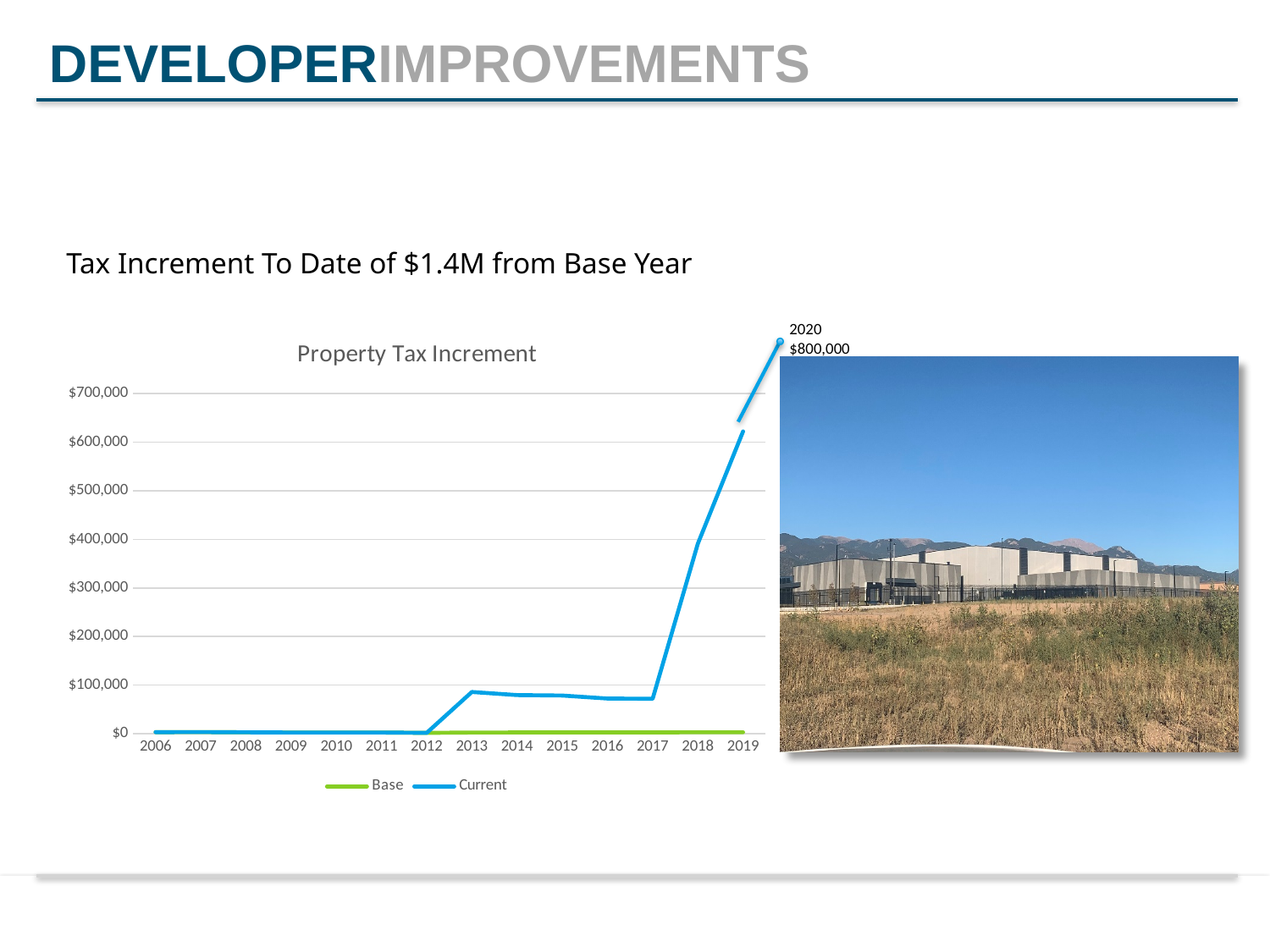
How many years are labelled on the x axis of the Property Tax Increment chart? 14 What are the two series named in the legend of the Property Tax Increment chart? Base and Current In 2019, which series has the larger value, Base or Current? Current Is the Current value for 2018 greater or less than $300,000? greater What is the title of the chart on the slide? Property Tax Increment How many series does the legend of the Property Tax Increment chart list? 2 What value is labelled for the Current series at 2020 on the Property Tax Increment chart? $800,000 Is the Current value for 2019 greater or less than $500,000? greater Is the Current value for 2013 greater or less than $100,000? less What kind of chart is the Property Tax Increment chart? line chart Does the Current series rise or fall from 2017 to 2019? rise Among the years 2006 to 2019, which year has the highest Current value? 2019